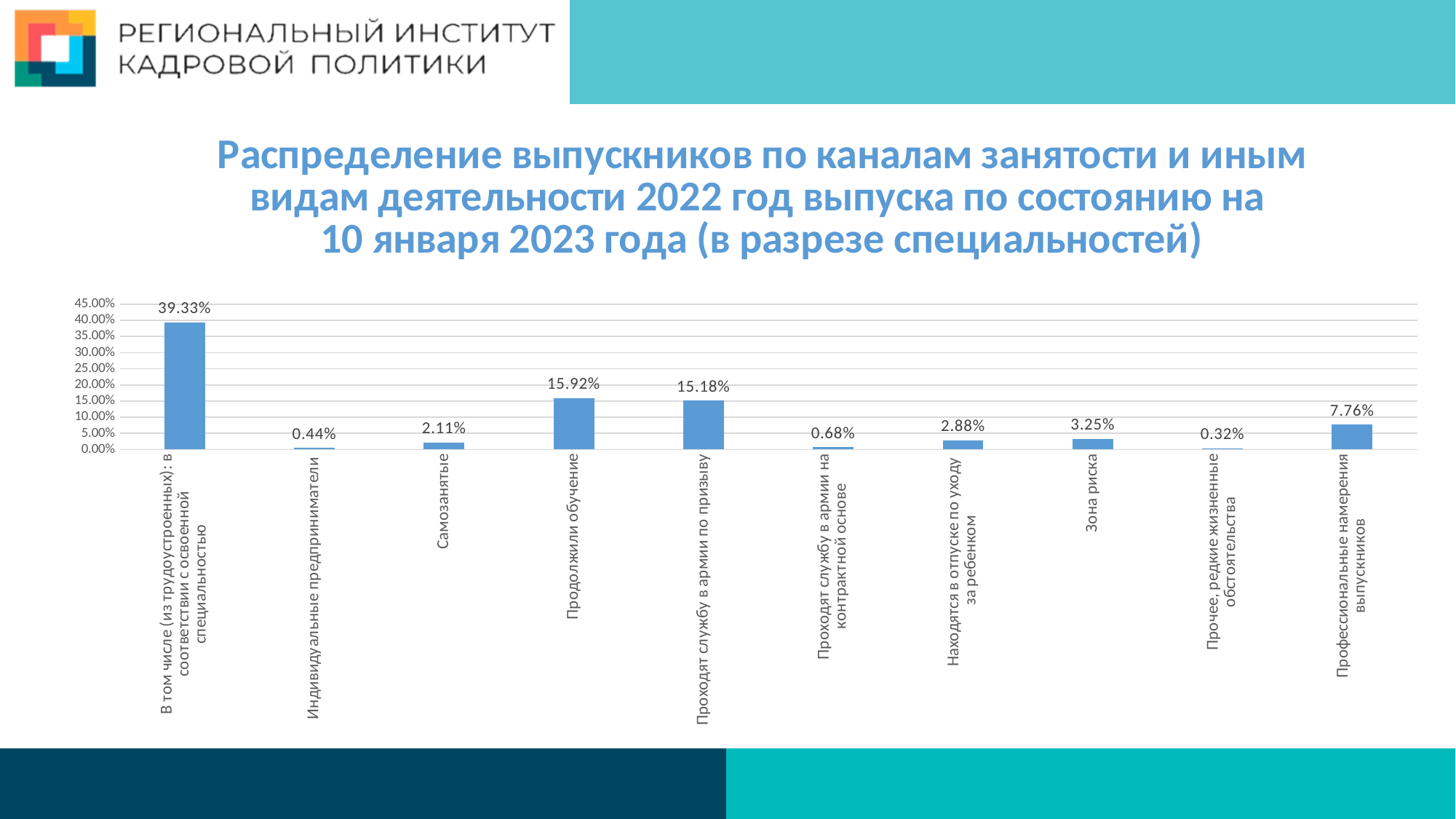
How many categories are shown in the chart? 10 Is the value for «Проходят службу в армии по призыву» greater or less than 10.00%? greater What is the value for «Продолжили обучение»? 15.92% What is the value for «Профессиональные намерения выпускников»? 7.76% Which is larger: «Зона риска» or «Находятся в отпуске по уходу за ребенком»? Зона риска What is the difference between «Продолжили обучение» and «Проходят службу в армии по призыву»? 0.74% What is the value for «Индивидуальные предприниматели»? 0.44% Which category has the lowest value? Прочее, редкие жизненные обстоятельства What is the value for «Самозанятые»? 2.11% What is the value for «Зона риска»? 3.25% What kind of chart is shown on the slide? Bar chart Which category has the highest value? В том числе (из трудоустроенных): в соответствии с освоенной специальностью